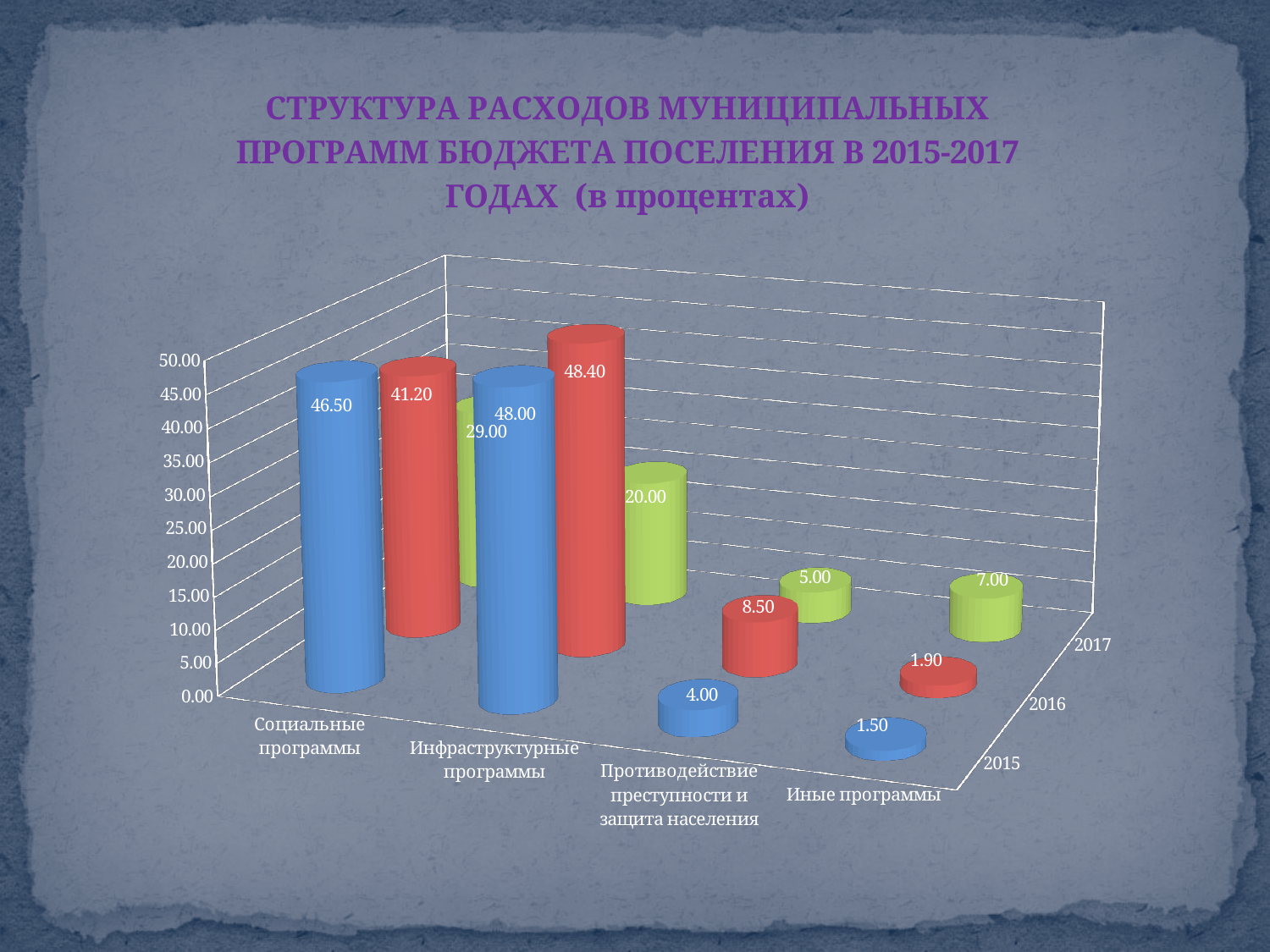
Do the values for Социальные программы rise or fall from 2015 to 2017? Fall Which category has the lowest value in 2015? Иные программы How many program categories are shown on the x axis? 4 Which is larger for Инфраструктурные программы: the 2017 value or the 2015 value? 2015 Which category has the highest value in 2017? Социальные программы Which years are shown on the depth axis of the chart? 2015, 2016, 2017 What is the value for Противодействие преступности и защита населения in 2016? 8.50 What is the value for Инфраструктурные программы in 2016? 48.40 What is the value for Иные программы in 2017? 7.00 What is the difference between the 2015 and 2017 values for Социальные программы? 17.50 What kind of chart is shown on the slide? Bar chart What is the value for Социальные программы in 2015? 46.50